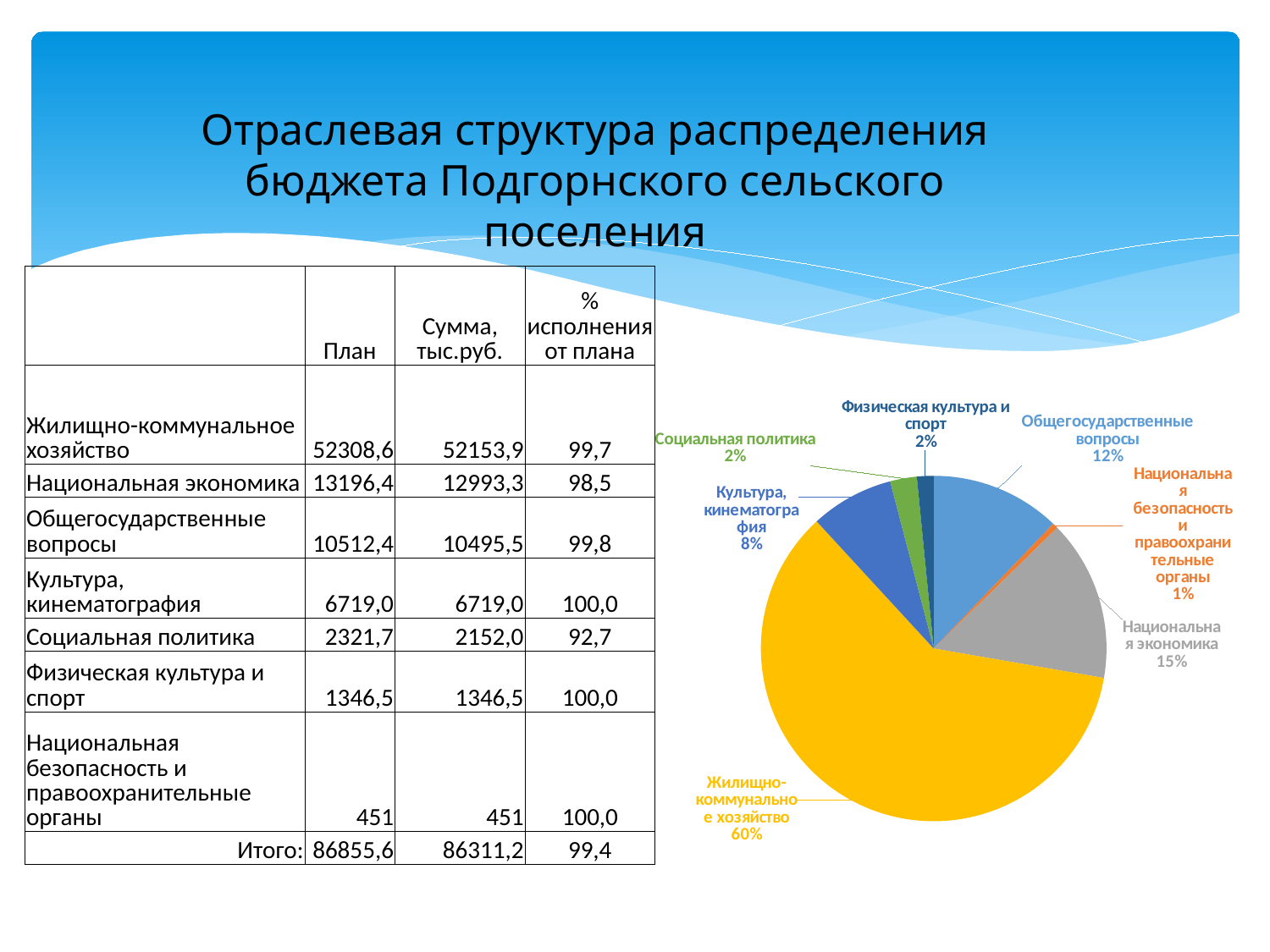
By how many percentage points does the share of Жилищно-коммунальное хозяйство exceed that of Национальная экономика? 45 What share of the pie does Культура, кинематография have? 8% What share of the pie does Жилищно-коммунальное хозяйство have? 60% What kind of chart is shown on the slide? Pie chart What share of the pie does Национальная экономика have? 15% Which category has the smallest slice of the pie? Национальная безопасность и правоохранительные органы What colour is the slice for Жилищно-коммунальное хозяйство? Yellow Which category has the largest slice of the pie? Жилищно-коммунальное хозяйство How many slices does the pie chart have? 7 Which slice is larger: Национальная экономика or Общегосударственные вопросы? Национальная экономика